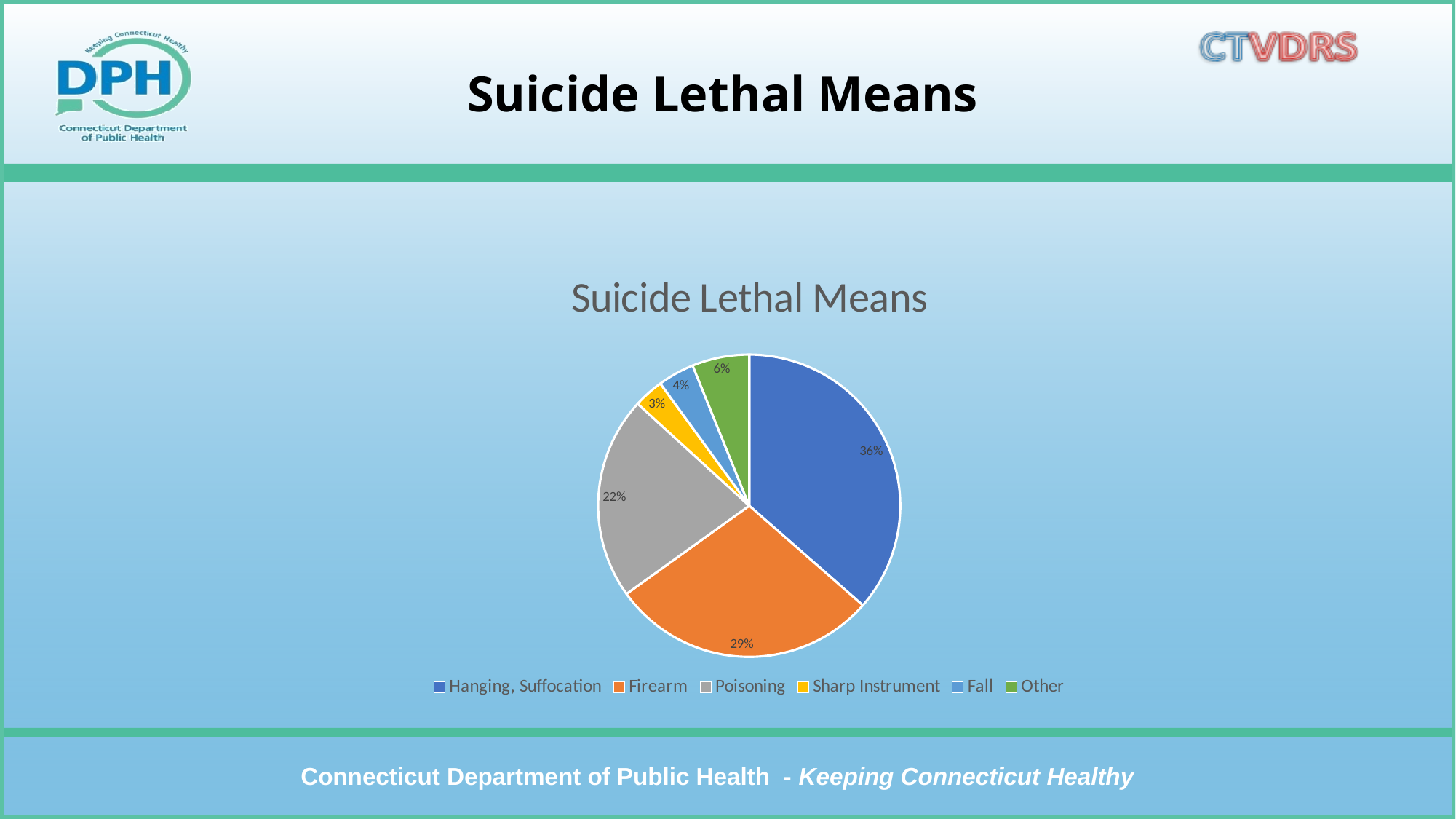
What share of the pie does Poisoning account for? 22% What is the difference in percentage points between Hanging, Suffocation and Firearm? 7 What share of the pie does Fall account for? 4% What kind of chart is shown on the slide? pie chart What share of the pie does Sharp Instrument account for? 3% Which category has the largest slice of the pie? Hanging, Suffocation What is the title of the chart? Suicide Lethal Means Which category has the smallest slice of the pie? Sharp Instrument How many categories does the legend list? 6 Which is larger, the share for Other or the share for Fall? Other